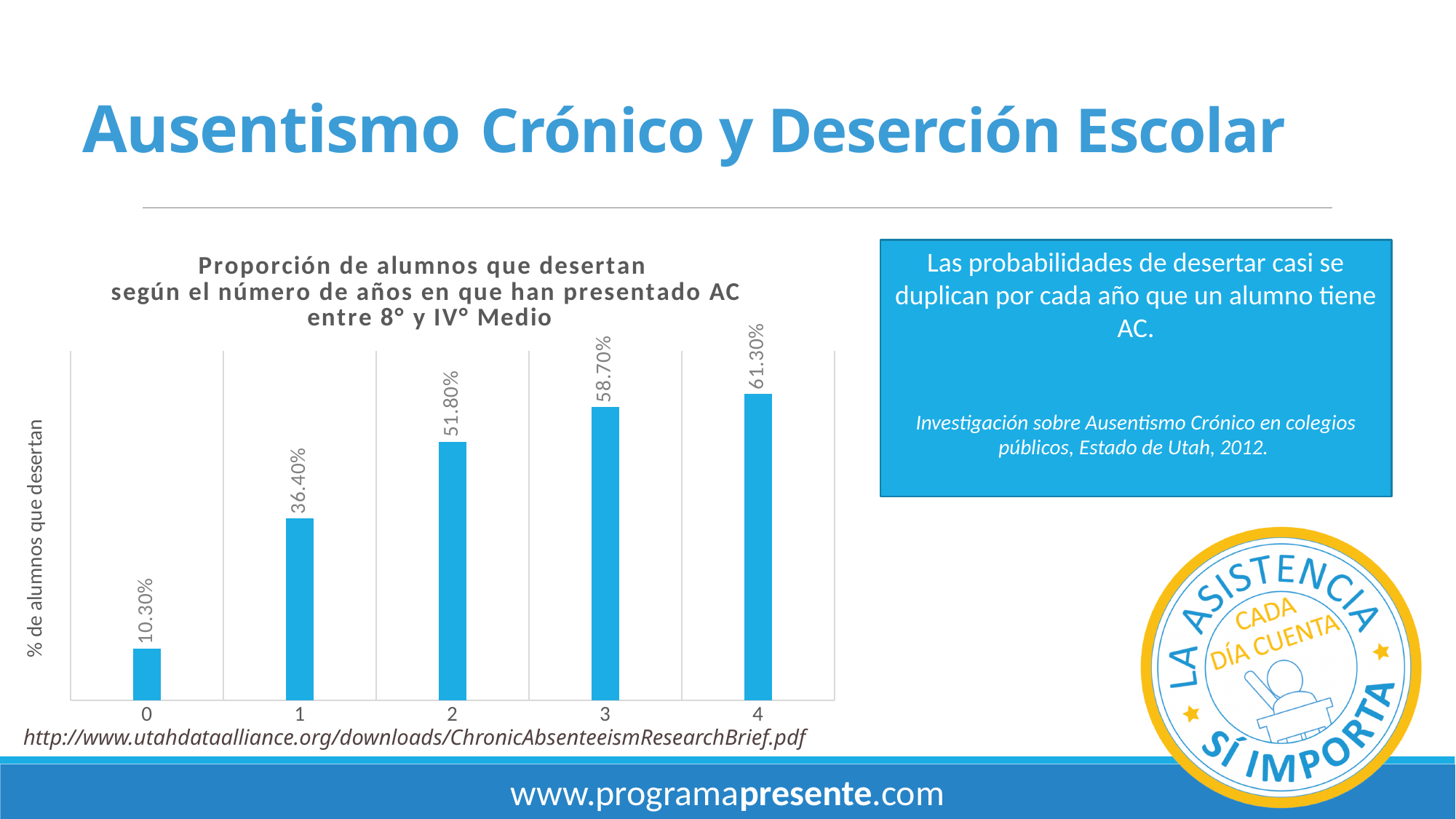
Do the values rise or fall as the number of years increases along the x axis? rise What is the value for category 2? 51.80% What is the value for category 0? 10.30% What is the value for category 4? 61.30% What is the label of the y axis? % de alumnos que desertan What kind of chart is shown? bar chart Which category has the lowest value? 0 What is the difference between the values for category 4 and category 3? 2.60% What is the difference between the values for category 1 and category 0? 26.10% How many categories are shown on the x axis? 5 Which is larger, the value for category 1 or the value for category 2? 2 Which category has the highest value? 4